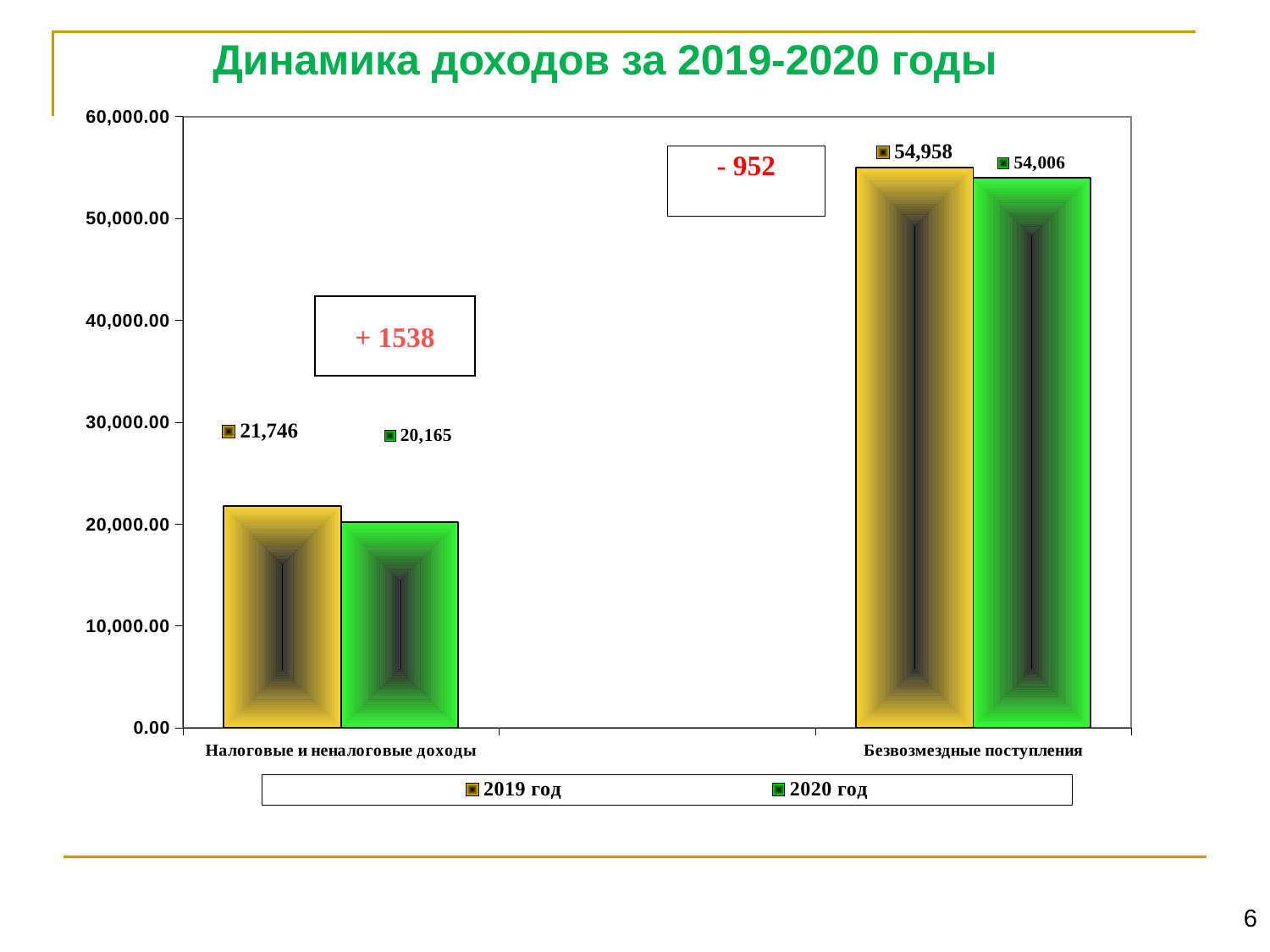
What is the value for 2020 год in the category Безвозмездные поступления? 54,006 How many categories are shown on the x axis? 2 Is the value for 2020 год in Налоговые и неналоговые доходы greater or less than 30,000.00? less What is the value for 2020 год in the category Налоговые и неналоговые доходы? 20,165 What is the difference between the 2019 год and 2020 год values for Безвозмездные поступления? 952 Which category has the highest value for 2019 год? Безвозмездные поступления How many series does the legend list? 2 What is the value for 2019 год in the category Безвозмездные поступления? 54,958 What is the value for 2019 год in the category Налоговые и неналоговые доходы? 21,746 What type of chart is shown on the slide? Bar chart Which category has the lowest value for 2020 год? Налоговые и неналоговые доходы What is the chart's title? Динамика доходов за 2019-2020 годы